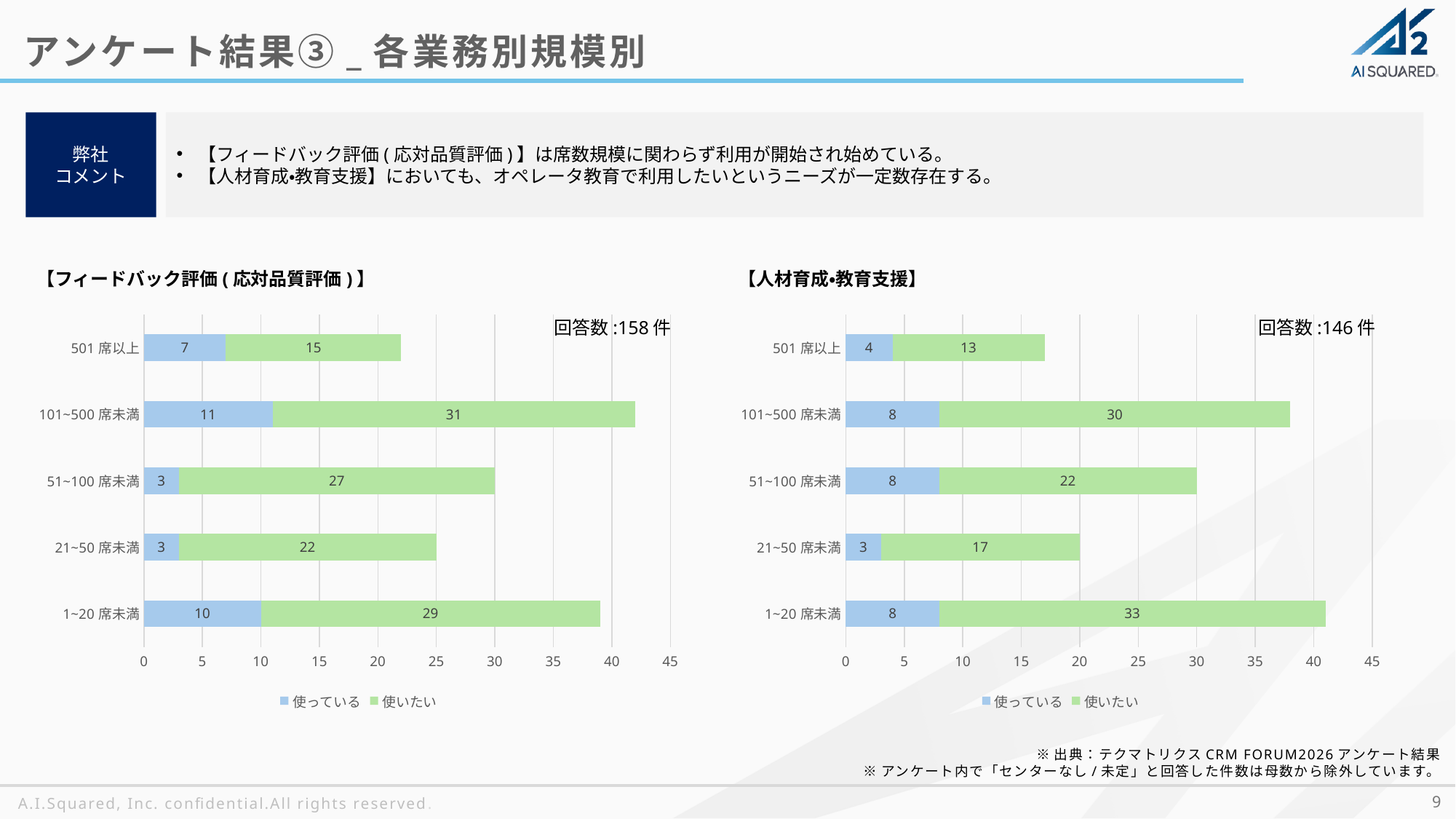
In the right chart (人材育成・教育支援), which is larger: the 使いたい value for 51~100席未満 or for 21~50席未満? 51~100席未満 How many series does the legend of the right chart (人材育成・教育支援) list? 2 What kind of chart is the left chart (フィードバック評価)? Stacked bar chart In the right chart (人材育成・教育支援), what is the 使いたい value for 1~20席未満? 33 In the right chart (人材育成・教育支援), what is the total of the stacked bar for 101~500席未満? 38 How many categories are shown in the left chart (フィードバック評価)? 5 In the left chart (フィードバック評価), which category has the highest 使いたい value? 101~500席未満 In the left chart (フィードバック評価), what is the difference between the 使いたい values for 51~100席未満 and 21~50席未満? 5 In the left chart (フィードバック評価), what is the total of the stacked bar for 1~20席未満? 39 What is the 回答数 shown on the right chart (人材育成・教育支援)? 146件 In the right chart (人材育成・教育支援), which category has the lowest 使いたい value? 501席以上 In the left chart (フィードバック評価), what is the 使っている value for 101~500席未満? 11